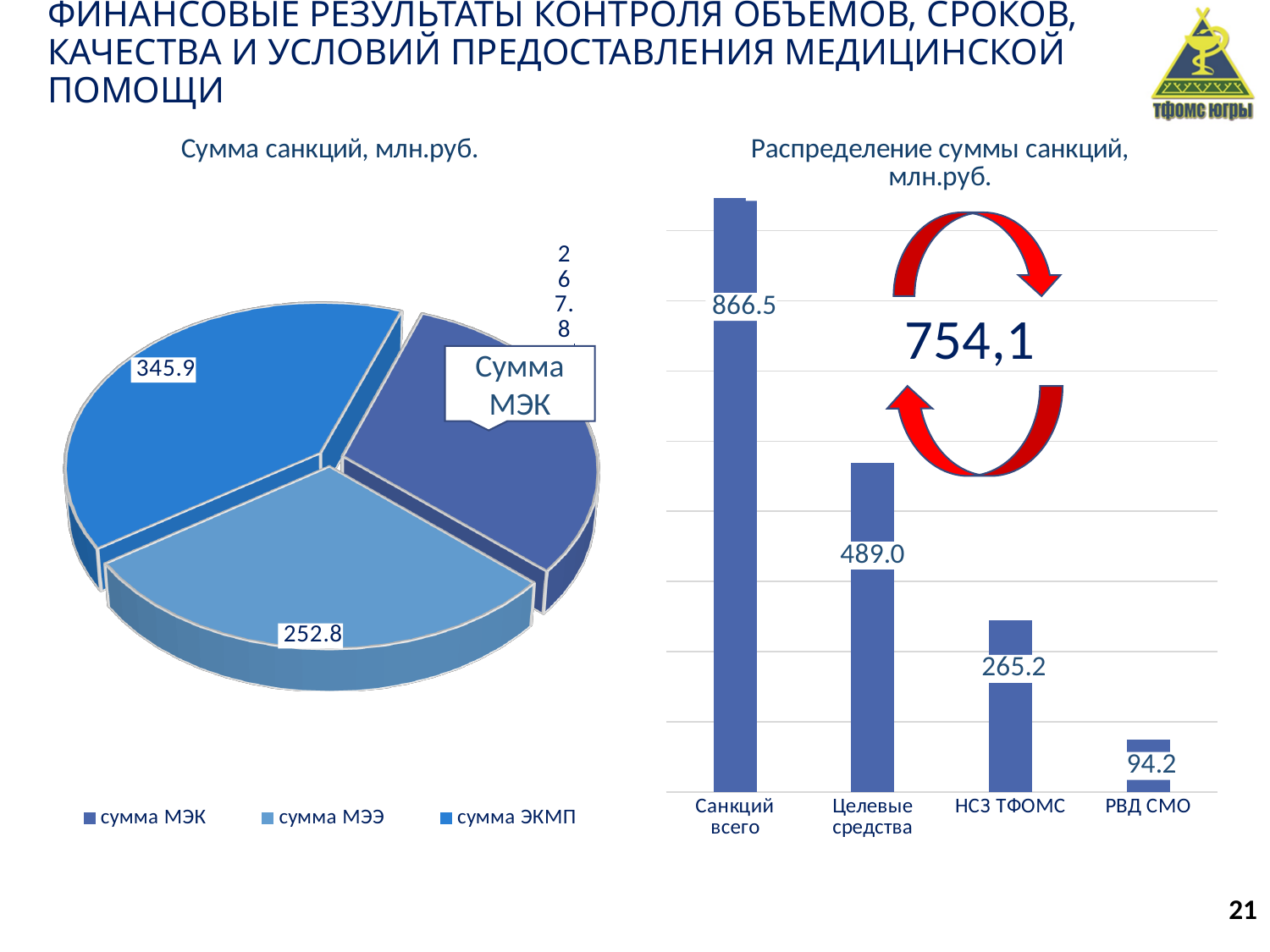
How many entries does the legend of the pie chart 'Сумма санкций, млн.руб.' list? 3 In the pie chart 'Сумма санкций, млн.руб.', which slice is the largest? сумма ЭКМП In the pie chart 'Сумма санкций, млн.руб.', what is the value for 'сумма МЭЭ'? 252.8 What type of chart is the chart on the left of the slide? Pie chart In the pie chart 'Сумма санкций, млн.руб.', which is larger: 'сумма МЭК' or 'сумма МЭЭ'? сумма МЭК In the bar chart 'Распределение суммы санкций, млн.руб.', how many bars are shown? 4 In the bar chart 'Распределение суммы санкций, млн.руб.', what is the value for 'Целевые средства'? 489.0 In the bar chart 'Распределение суммы санкций, млн.руб.', what is the value for 'РВД СМО'? 94.2 In the bar chart 'Распределение суммы санкций, млн.руб.', what is the difference between 'Целевые средства' and 'НСЗ ТФОМС'? 223.8 In the bar chart 'Распределение суммы санкций, млн.руб.', what is the value for 'Санкций всего'? 866.5 In the pie chart 'Сумма санкций, млн.руб.', what is the value for 'сумма ЭКМП'? 345.9 In the bar chart 'Распределение суммы санкций, млн.руб.', which category has the lowest value? РВД СМО